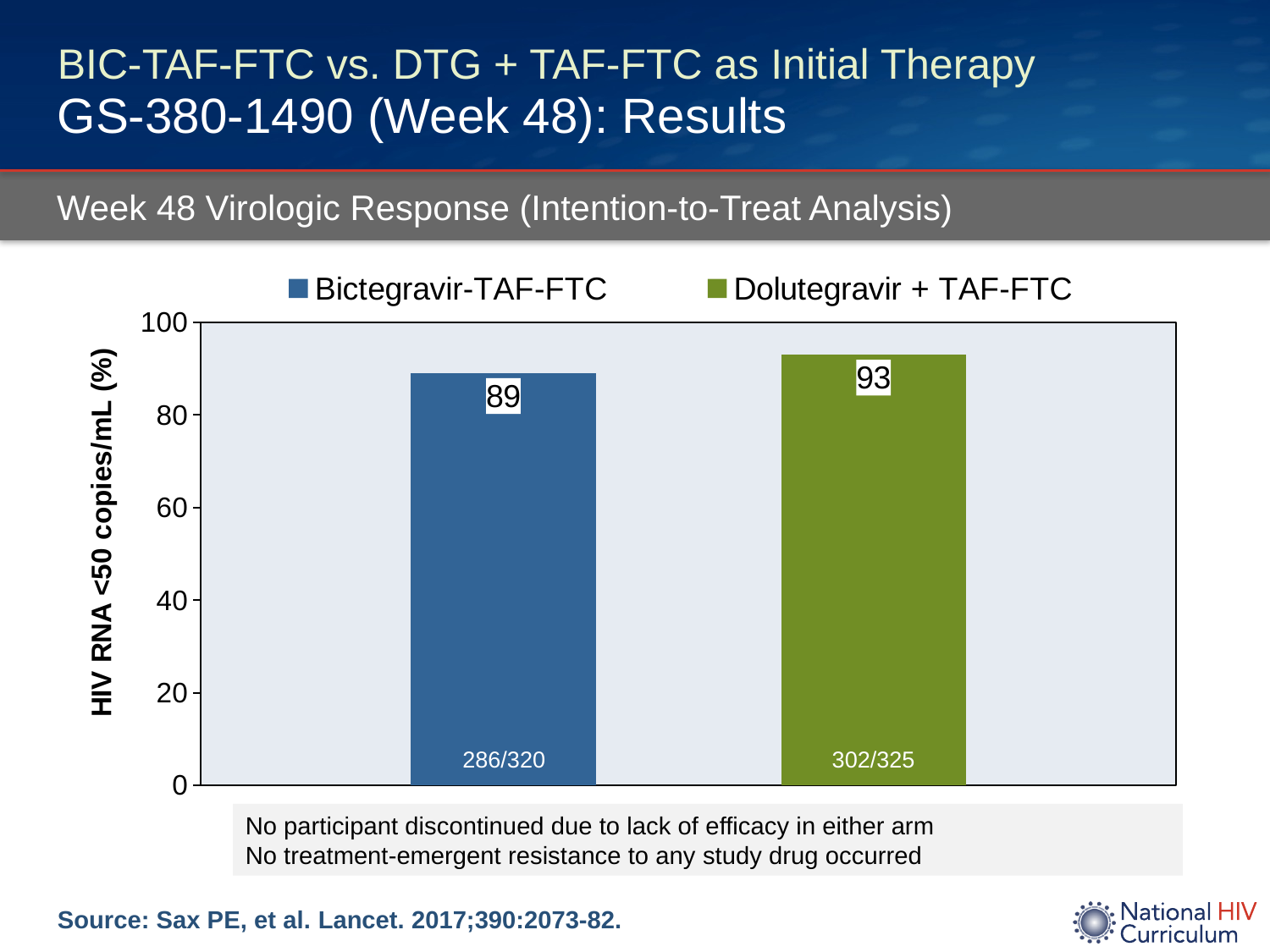
Is the value for Bictegravir-TAF-FTC greater or less than 80? greater What is the value for Bictegravir-TAF-FTC? 89 Which series has the higher value? Dolutegravir + TAF-FTC Which series has the lower value? Bictegravir-TAF-FTC How many series does the legend list? 2 What fraction is printed inside the Dolutegravir + TAF-FTC bar? 302/325 What is the value for Dolutegravir + TAF-FTC? 93 What is the y-axis label of the chart? HIV RNA <50 copies/mL (%) What kind of chart is shown? bar chart What colour is the Dolutegravir + TAF-FTC bar? green What fraction is printed inside the Bictegravir-TAF-FTC bar? 286/320 What is the difference between the Dolutegravir + TAF-FTC value and the Bictegravir-TAF-FTC value? 4